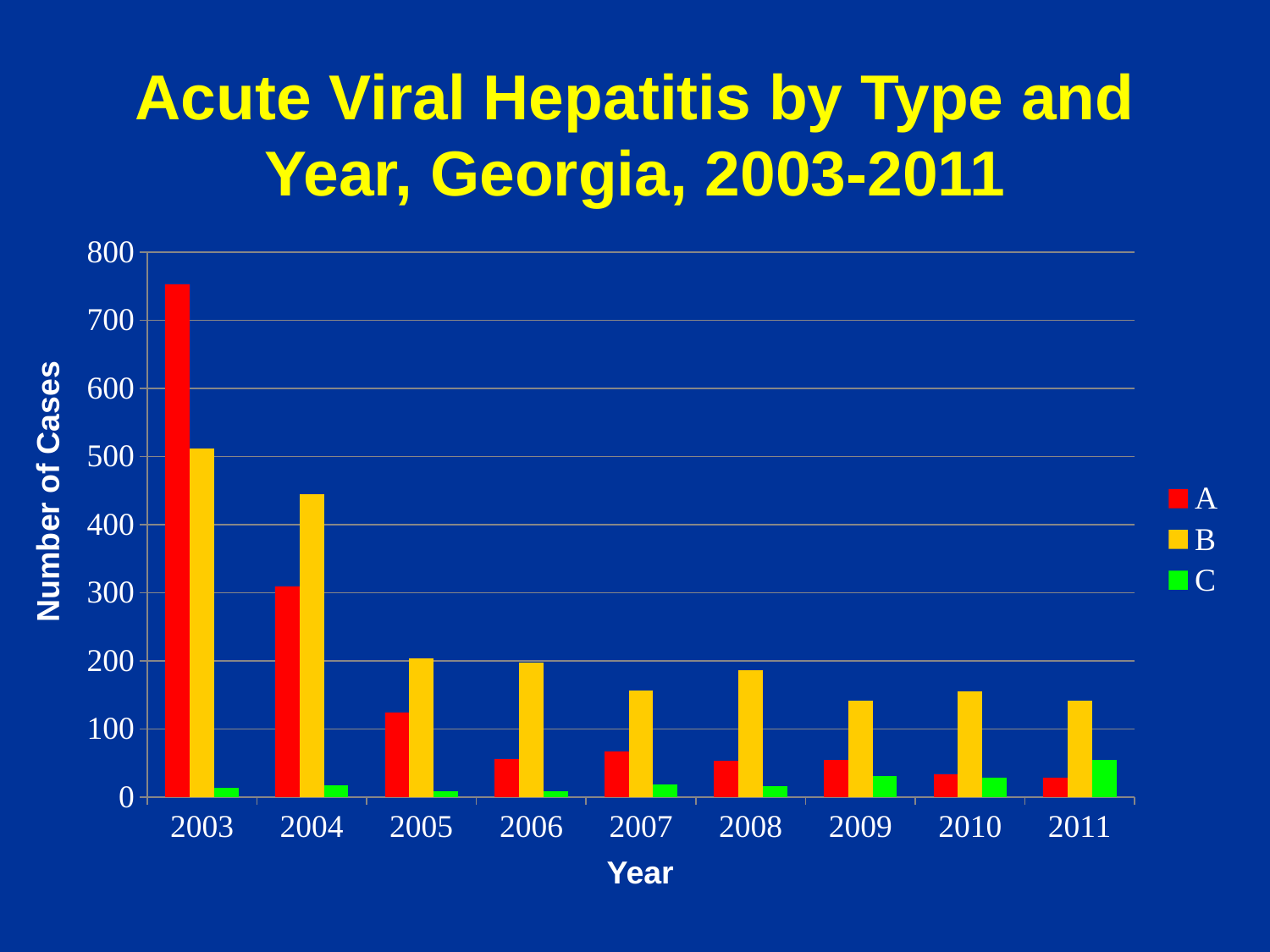
How many series does the legend list? 3 Do the values for series A generally rise or fall from 2003 to 2011? fall In 2003, which series has more cases, A or B? A What kind of chart is shown on the slide? bar chart In which year is the number of cases for series C highest? 2011 Is the value for series A in 2004 greater or less than 200? greater In which year is the number of cases for series B highest? 2003 Is the value for series B in 2004 greater or less than 500? less How many years are shown on the x axis? 9 In which year is the number of cases for series A highest? 2003 In 2005, which series has more cases, A or B? B Is the value for series A in 2003 greater or less than 700? greater